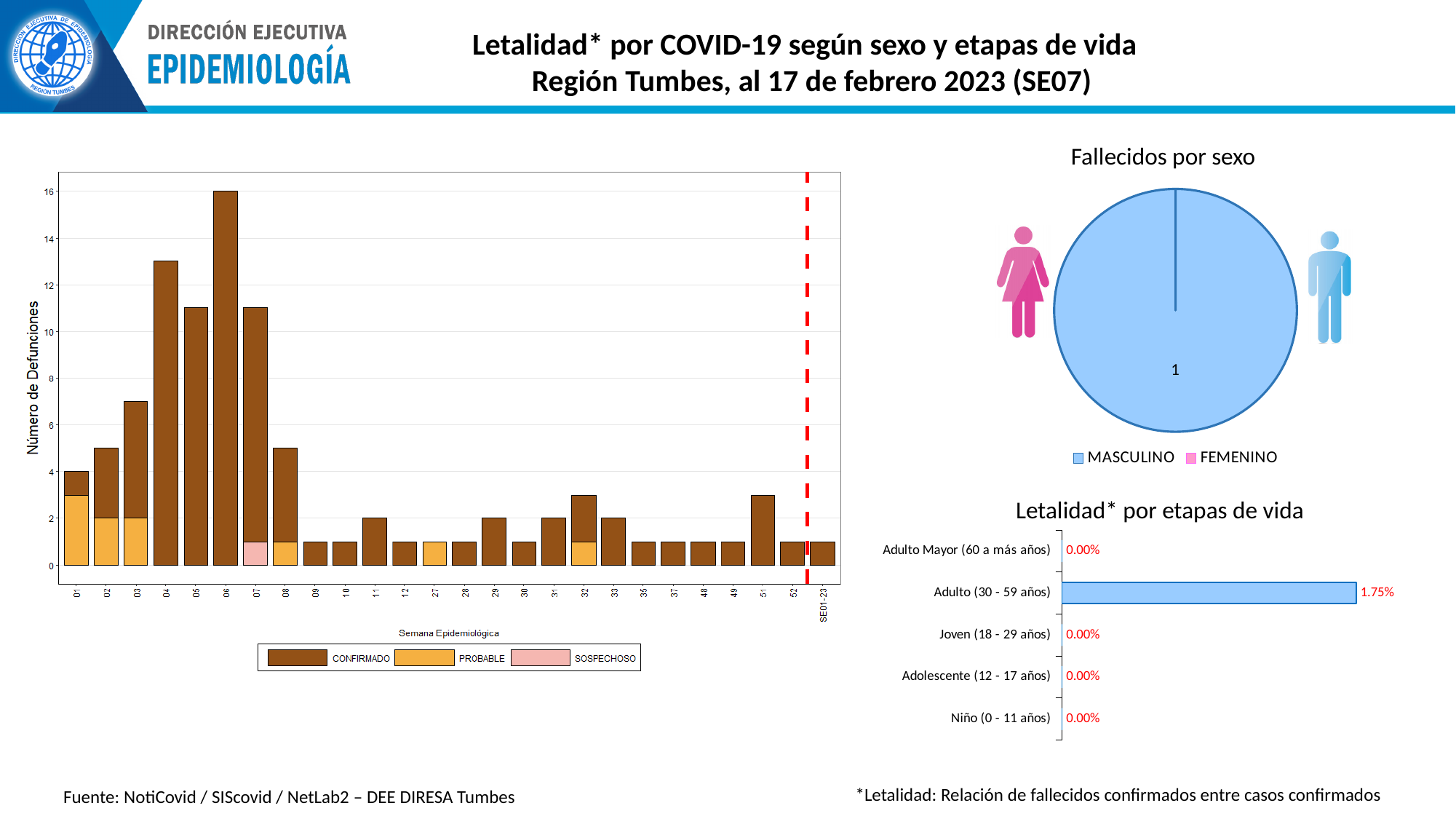
In the 'Fallecidos por sexo' pie chart, which sex accounts for the larger share of deaths? MASCULINO What kind of chart is the 'Número de Defunciones' by 'Semana Epidemiológica' chart on the left? Stacked bar chart In the 'Letalidad* por etapas de vida' chart, which age group has the highest letalidad? Adulto (30 - 59 años) How many age-group categories are shown in the 'Letalidad* por etapas de vida' chart? 5 How many entries does the legend of the 'Fallecidos por sexo' pie chart list? 2 In the left bar chart of 'Número de Defunciones', what is the total number of deaths in semana 06? 16 In the 'Letalidad* por etapas de vida' chart, what is the value for Adulto (30 - 59 años)? 1.75% In the left bar chart of 'Número de Defunciones', which semana epidemiológica has the highest number of deaths? 06 In the 'Fallecidos por sexo' pie chart, what value is printed on the MASCULINO slice? 1 In the 'Letalidad* por etapas de vida' chart, what is the value for Adulto Mayor (60 a más años)? 0.00% In the 'Letalidad* por etapas de vida' chart, what is the difference between the values for Adulto (30 - 59 años) and Joven (18 - 29 años)? 1.75% How many series does the legend of the left 'Número de Defunciones' bar chart list? 3